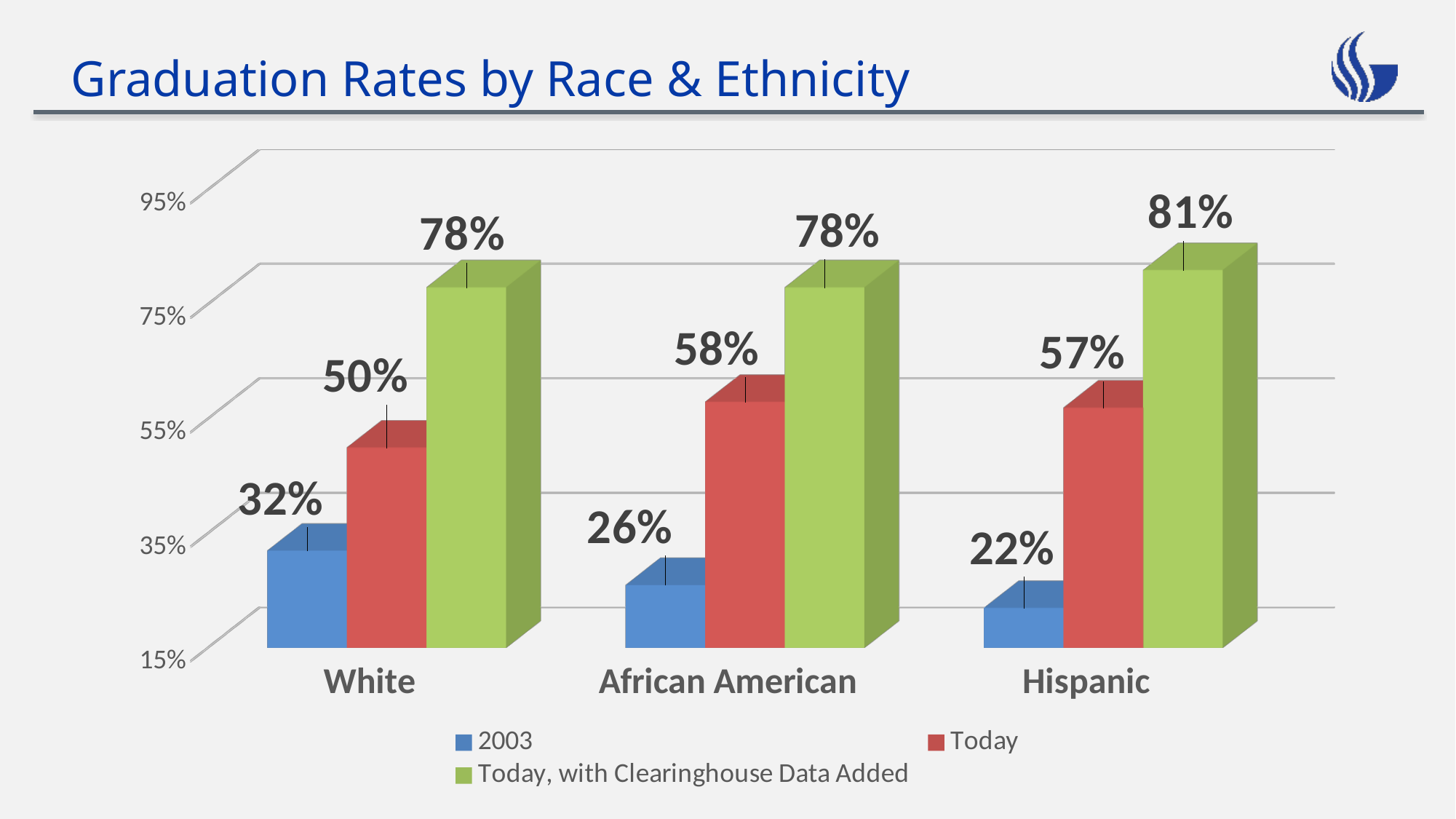
What is the graduation rate for Hispanic students in the 'Today, with Clearinghouse Data Added' series? 81% How many race/ethnicity categories are shown on the x axis? 3 What is the Today graduation rate for African American students? 58% What is the difference between the Today rate and the 2003 rate for White students? 18% What is the difference between the 'Today, with Clearinghouse Data Added' rate and the Today rate for Hispanic students? 24% Which is larger: the Today rate for African American students or the Today rate for Hispanic students? African American What kind of chart is shown on the slide? Bar chart What is the 2003 graduation rate for White students? 32% What is the title of the chart on the slide? Graduation Rates by Race & Ethnicity Which category has the highest value in the 'Today, with Clearinghouse Data Added' series? Hispanic Which category has the lowest 2003 graduation rate? Hispanic How many series does the legend list? 3